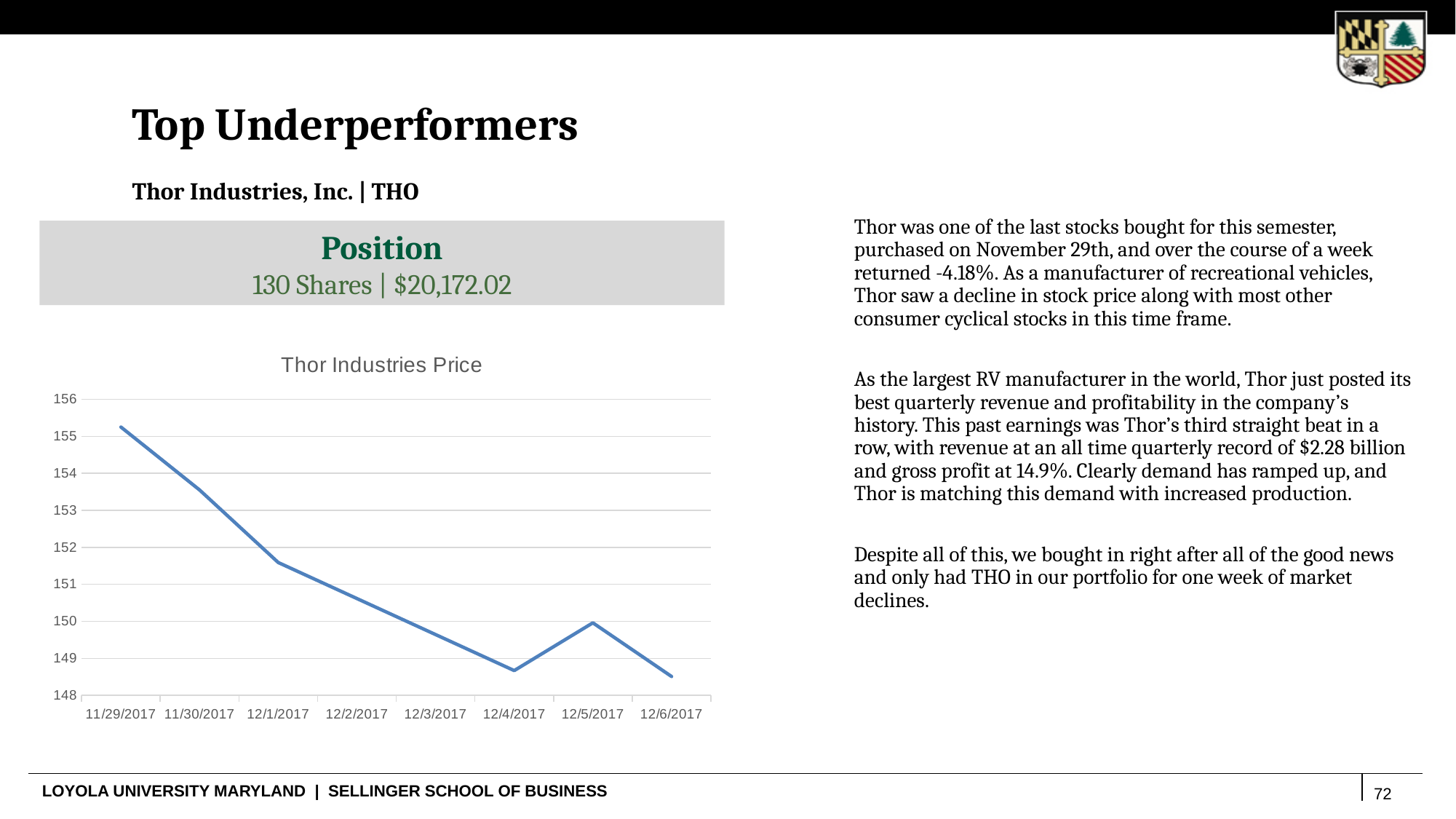
Is the value for 12/4/2017 greater or less than 149? less Is the value for 11/29/2017 greater or less than 155? greater Is the value for 12/1/2017 greater or less than 151? greater What kind of chart is shown on the slide? Line chart Which is larger, the value for 11/29/2017 or the value for 12/6/2017? 11/29/2017 What colour is the line in the chart? Blue How many dates are plotted on the x axis of the chart? 8 Does the Thor Industries price generally rise or fall from 11/29/2017 to 12/6/2017? Fall Which is larger, the value for 12/5/2017 or the value for 12/4/2017? 12/5/2017 What is the title of the chart? Thor Industries Price On which date is the Thor Industries price highest? 11/29/2017